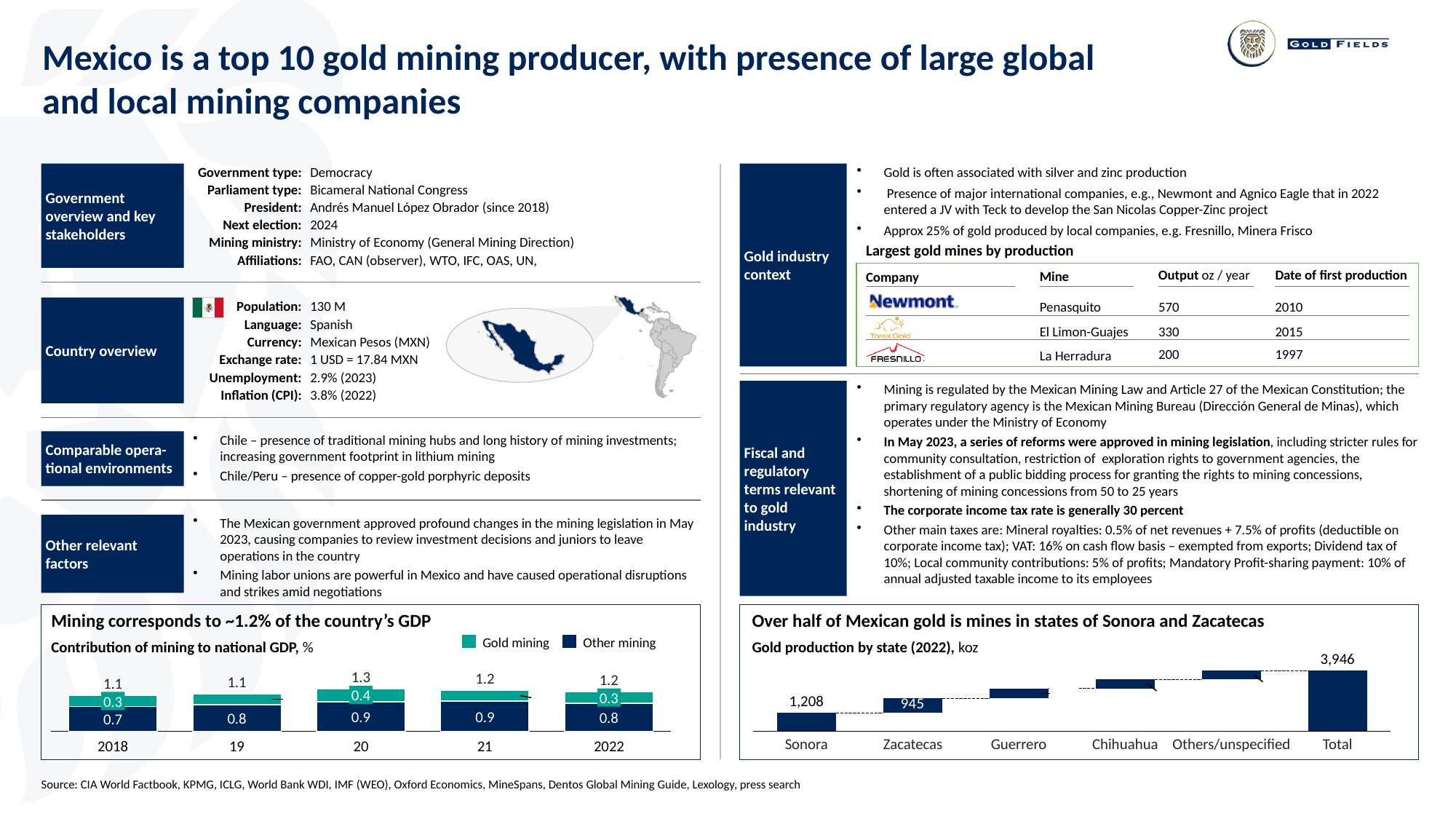
In the 'Gold production by state (2022)' chart, what is the Total value? 3,946 What kind of chart is the 'Contribution of mining to national GDP' chart on the bottom left? Stacked bar chart In the 'Gold production by state (2022)' chart, what is the value for Zacatecas? 945 In the 'Gold production by state (2022)' chart, what is the value for Sonora? 1,208 In the 'Contribution of mining to national GDP' chart, what is the difference between the Other mining values for 2020 and 2018? 0.2 How many years are shown on the x axis of the 'Contribution of mining to national GDP' chart? 5 How many series does the legend of the 'Contribution of mining to national GDP' chart list? 2 In the 'Gold production by state (2022)' chart, what is the difference between the values for Sonora and Zacatecas? 263 In the 'Contribution of mining to national GDP' chart, what is the value for Gold mining in 2018? 0.3 In the 'Contribution of mining to national GDP' chart, which year has the highest total contribution? 2020 In the 'Contribution of mining to national GDP' chart, what is the value for Other mining in 2020? 0.9 In the 'Contribution of mining to national GDP' chart, what is the total contribution of mining in 2020? 1.3